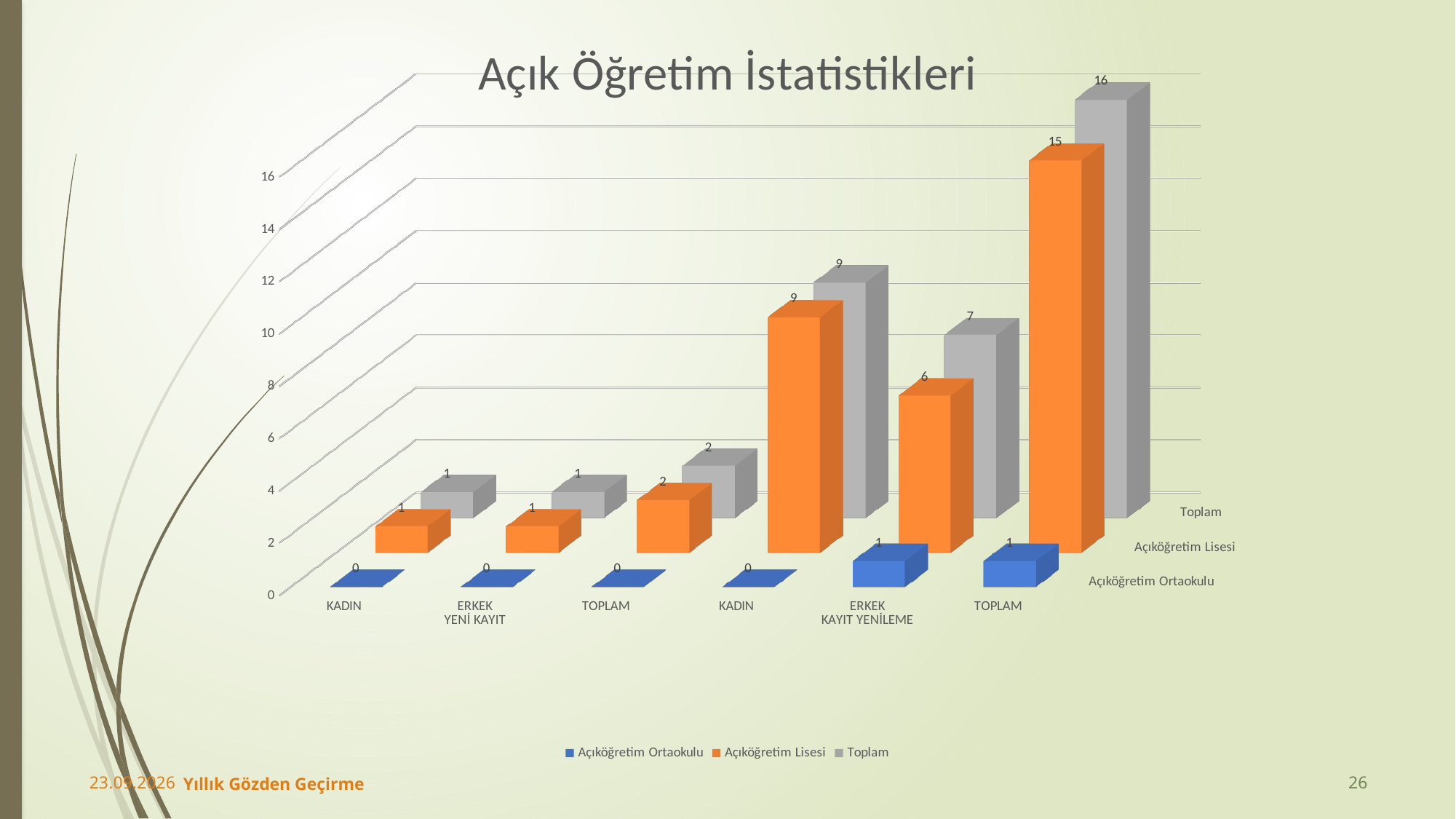
What is the title of the chart? Açık Öğretim İstatistikleri What kind of chart is shown on the slide? bar chart What is the Toplam value for TOPLAM under KAYIT YENİLEME? 16 Which category has the highest Toplam value? TOPLAM (KAYIT YENİLEME) How many categories are shown along the x axis? 6 Which series is shown in orange in the legend? Açıköğretim Lisesi Which is larger: the Toplam value for ERKEK under KAYIT YENİLEME or the Toplam value for KADIN under KAYIT YENİLEME? KADIN under KAYIT YENİLEME What is the Açıköğretim Ortaokulu value for ERKEK under KAYIT YENİLEME? 1 What is the Açıköğretim Lisesi value for TOPLAM under YENİ KAYIT? 2 What is the difference between the Açıköğretim Lisesi values for TOPLAM under KAYIT YENİLEME and TOPLAM under YENİ KAYIT? 13 How many series does the legend list? 3 What is the Açıköğretim Lisesi value for KADIN under KAYIT YENİLEME? 9